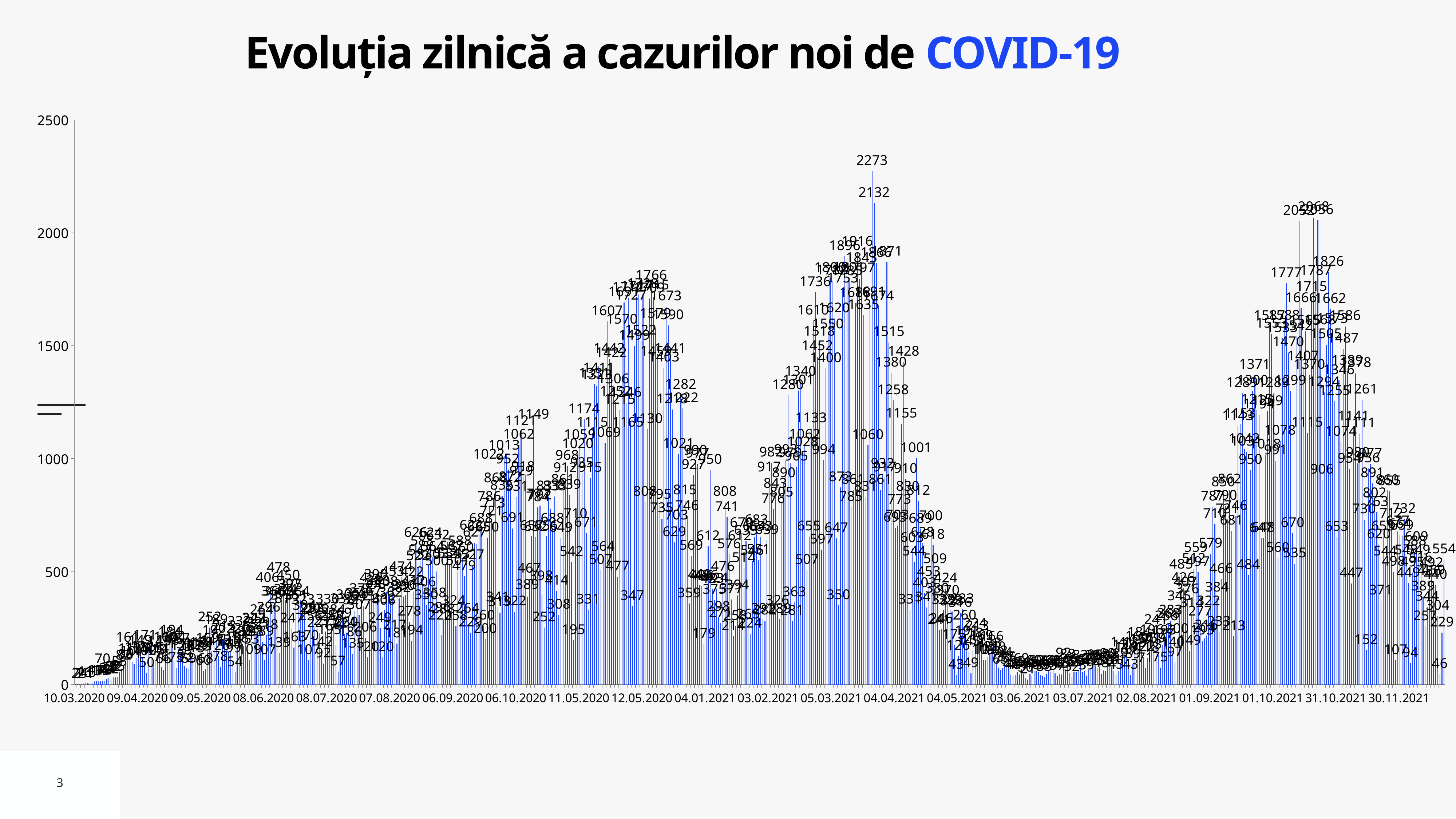
Between 04.04.2021 and 03.06.2021, do the daily values rise or fall? fall Which is larger, the bar labelled 2273 or the bar labelled 2132? 2273 Is the highest value on the chart greater or less than 2000? greater What is the title of the chart? Evoluția zilnică a cazurilor noi de COVID-19 What is the difference between the two tallest labelled bars, 2273 and 2132? 141 What kind of chart is shown on the slide? bar chart Are the values around 03.07.2021 greater or less than 500? less What is the highest daily value labelled on the chart? 2273 What is the first date label on the x axis? 10.03.2020 What is the highest tick value shown on the y axis? 2500 Is the highest value on the chart greater or less than 2500? less What is the value of the last (rightmost) bar on the chart? 554